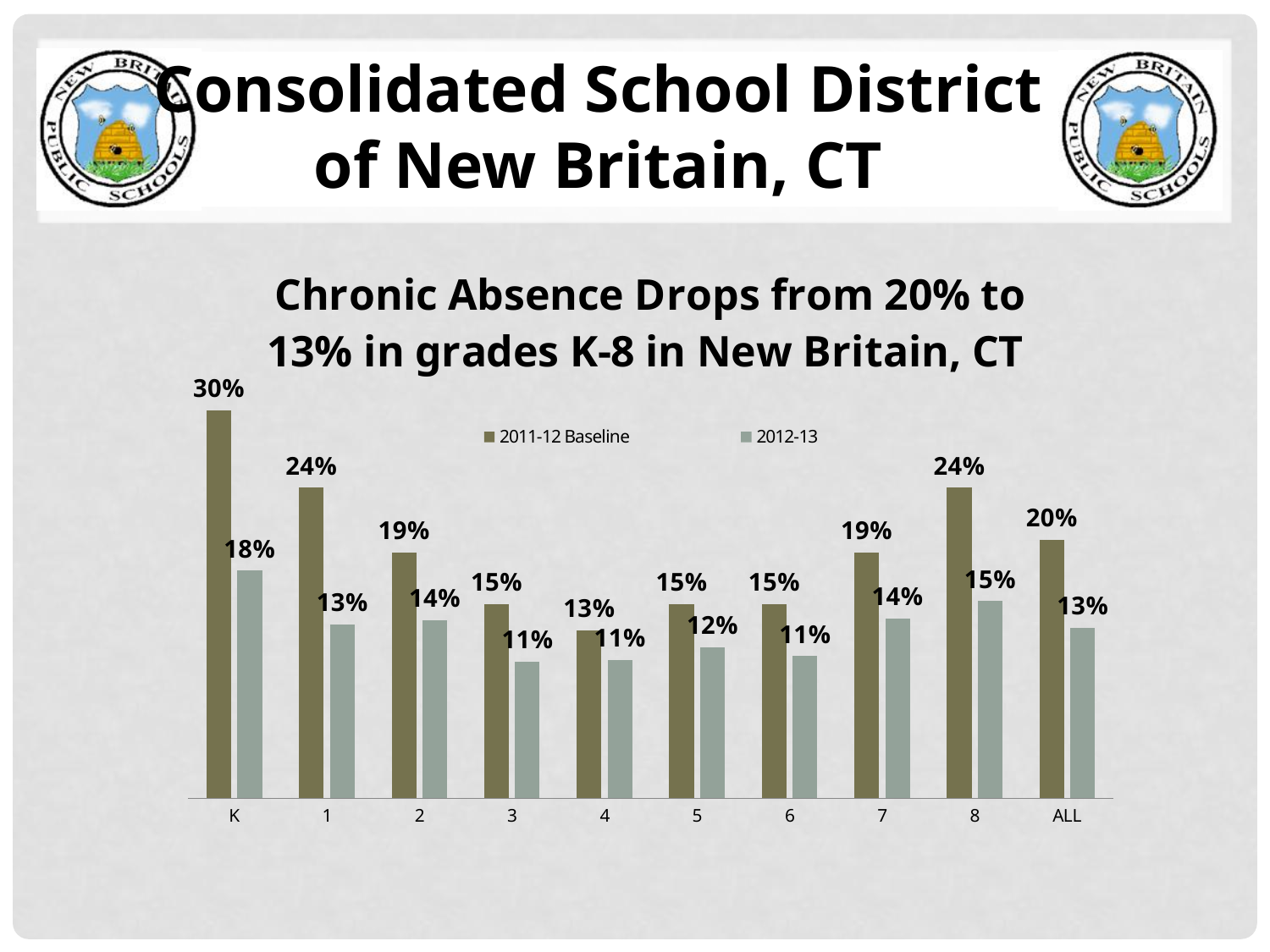
Which is larger for grade 7: the 2011-12 Baseline value or the 2012-13 value? 2011-12 Baseline How many categories are shown on the x axis? 10 What is the 2012-13 value for the ALL category? 13% Which category has the lowest 2011-12 Baseline value? 4 What is the difference between the 2011-12 Baseline and 2012-13 values for the ALL category? 7% What is the 2011-12 Baseline value for grade K? 30% What is the title of the chart? Chronic Absence Drops from 20% to 13% in grades K-8 in New Britain, CT What kind of chart is shown on the slide? Bar chart Which category has the highest 2011-12 Baseline value? K What is the 2012-13 value for grade 8? 15% How many series does the legend list? 2 What is the difference between the 2011-12 Baseline and 2012-13 values for grade K? 12%